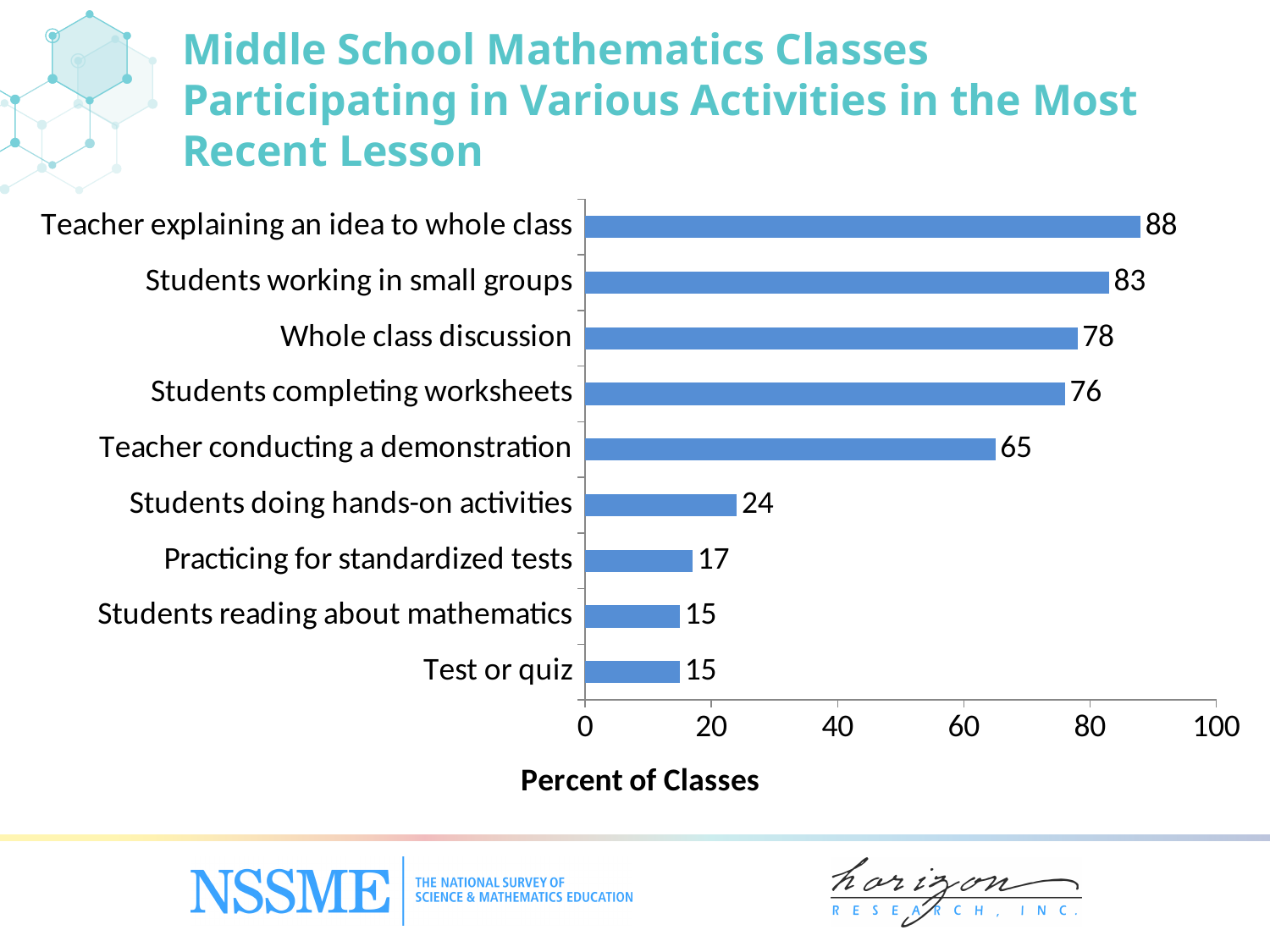
What is the value for Students reading about mathematics? 15 What is the difference between Students working in small groups and Whole class discussion? 5 What is the value for Teacher conducting a demonstration? 65 What percent of classes had the teacher explaining an idea to the whole class? 88 How many activities are shown in the chart? 9 What is the difference between Teacher explaining an idea to whole class and Test or quiz? 73 What is the label of the horizontal axis? Percent of Classes What is the value for Students doing hands-on activities? 24 Which is larger: Students completing worksheets or Teacher conducting a demonstration? Students completing worksheets Which activity has the highest percent of classes? Teacher explaining an idea to whole class What kind of chart is shown on the slide? Bar chart Which is larger: Practicing for standardized tests or Students doing hands-on activities? Students doing hands-on activities